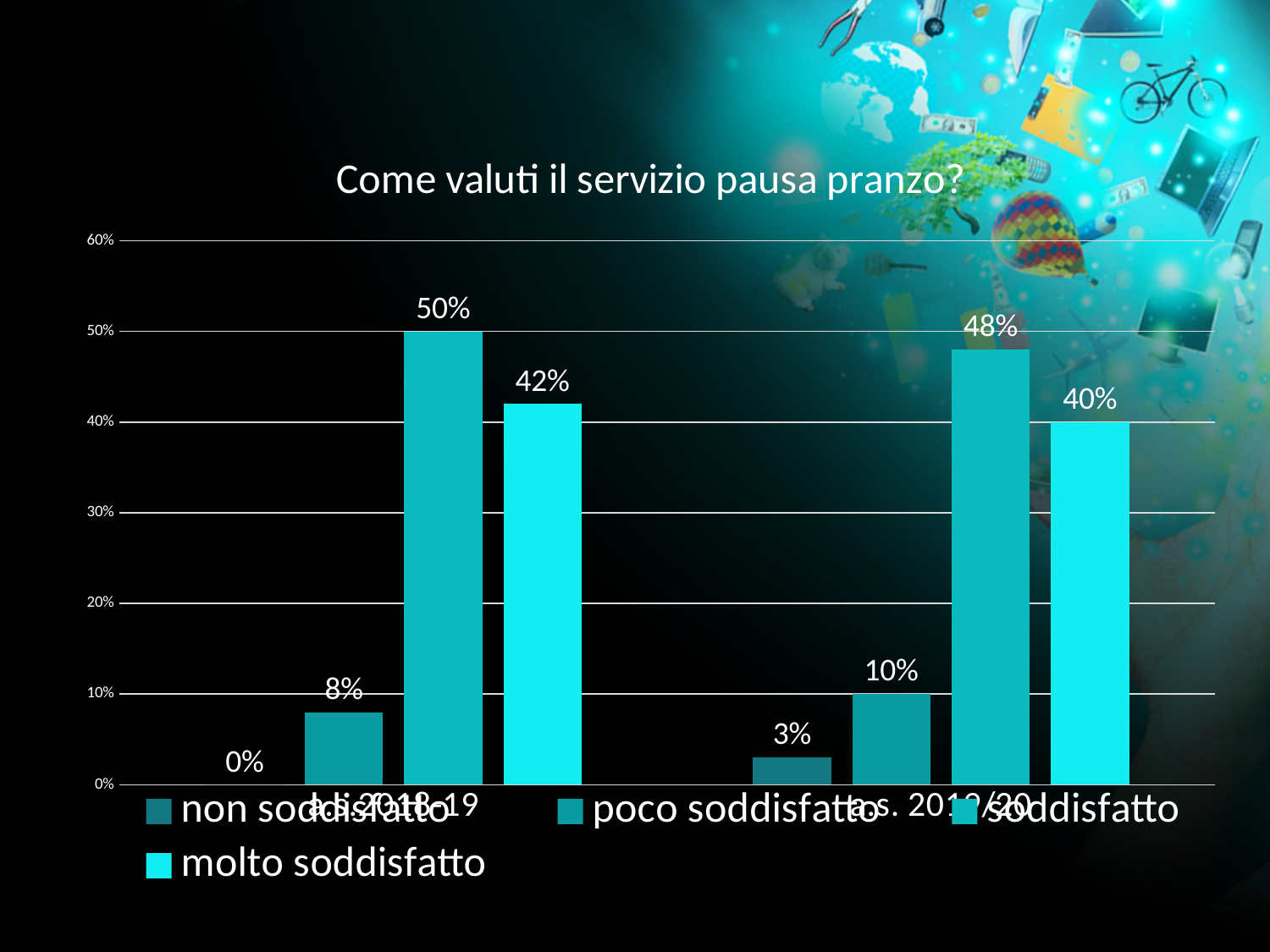
What is the value for 'poco soddisfatto' in the right group (a.s. 2019/20)? 10% What is the value for 'molto soddisfatto' in the right group (a.s. 2019/20)? 40% What is the difference between the 'soddisfatto' values of the left group (50%) and the right group (48%)? 2% Which series has the lowest value in the left group (a.s. 2018/19)? non soddisfatto What kind of chart is shown on the slide? bar chart How many series does the legend list? 4 What is the value for 'non soddisfatto' in the left group (a.s. 2018/19)? 0% How many category groups are plotted on the x axis? 2 Which series has the highest value in the right group (a.s. 2019/20)? soddisfatto Which is larger: 'molto soddisfatto' in the left group (a.s. 2018/19) or 'molto soddisfatto' in the right group (a.s. 2019/20)? left group (a.s. 2018/19) What is the title of the chart? Come valuti il servizio pausa pranzo? What is the value for 'soddisfatto' in the left group (a.s. 2018/19)? 50%